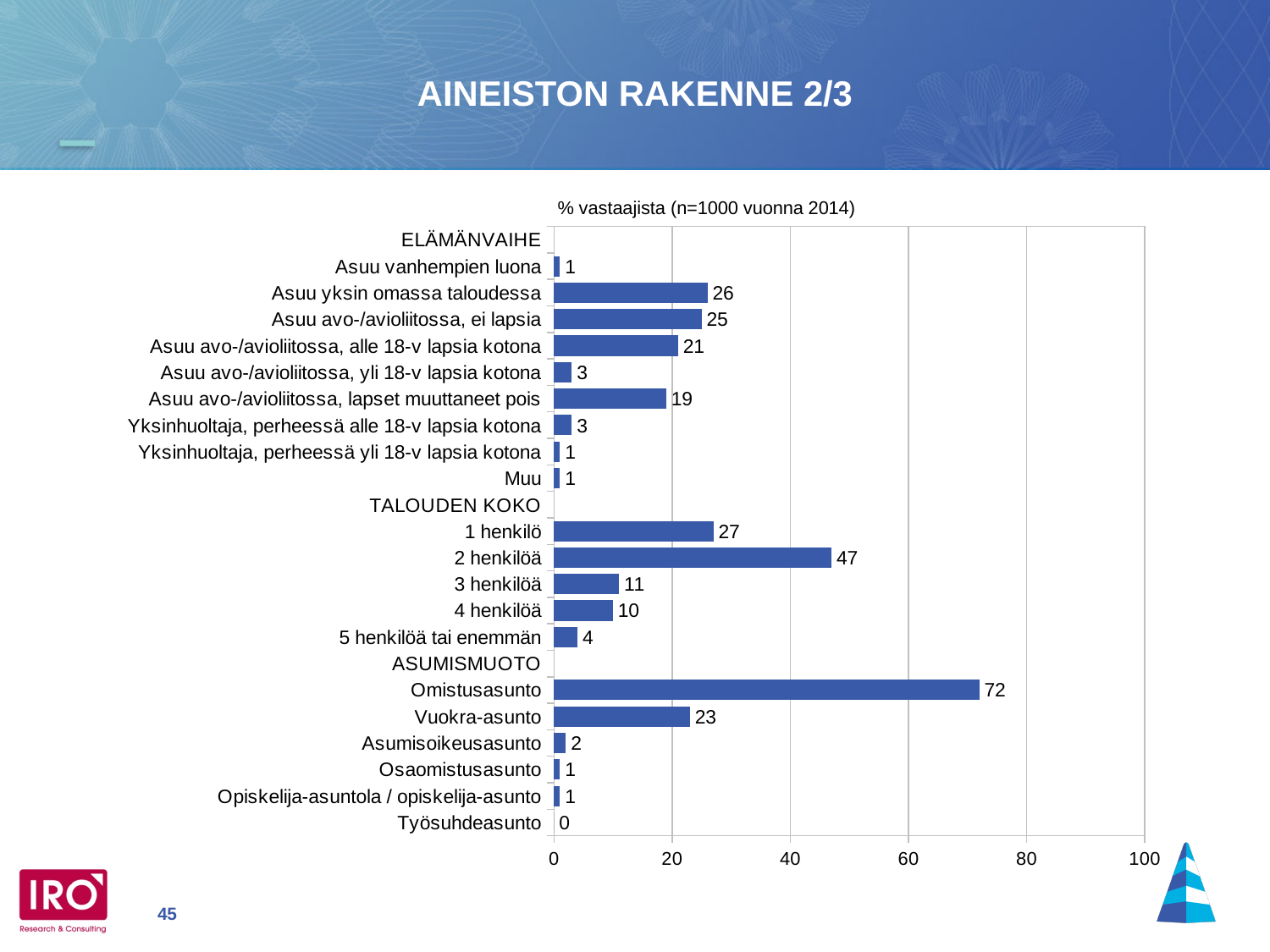
What is the value for Omistusasunto? 72 What is the value for 2 henkilöä? 47 What is the difference between the values for Omistusasunto and Vuokra-asunto? 49 Which category has the lowest value in the chart? Työsuhdeasunto What is the difference between the values for 2 henkilöä and 1 henkilö? 20 What is the title shown above the chart? % vastaajista (n=1000 vuonna 2014) What is the value for Vuokra-asunto? 23 Which category has the highest value in the chart? Omistusasunto What is the value for Asuu avo-/avioliitossa, lapset muuttaneet pois? 19 Which is larger, the value for Asuu yksin omassa taloudessa or the value for Asuu avo-/avioliitossa, alle 18-v lapsia kotona? Asuu yksin omassa taloudessa How many categories are listed under TALOUDEN KOKO? 5 What kind of chart is shown on the slide? Bar chart